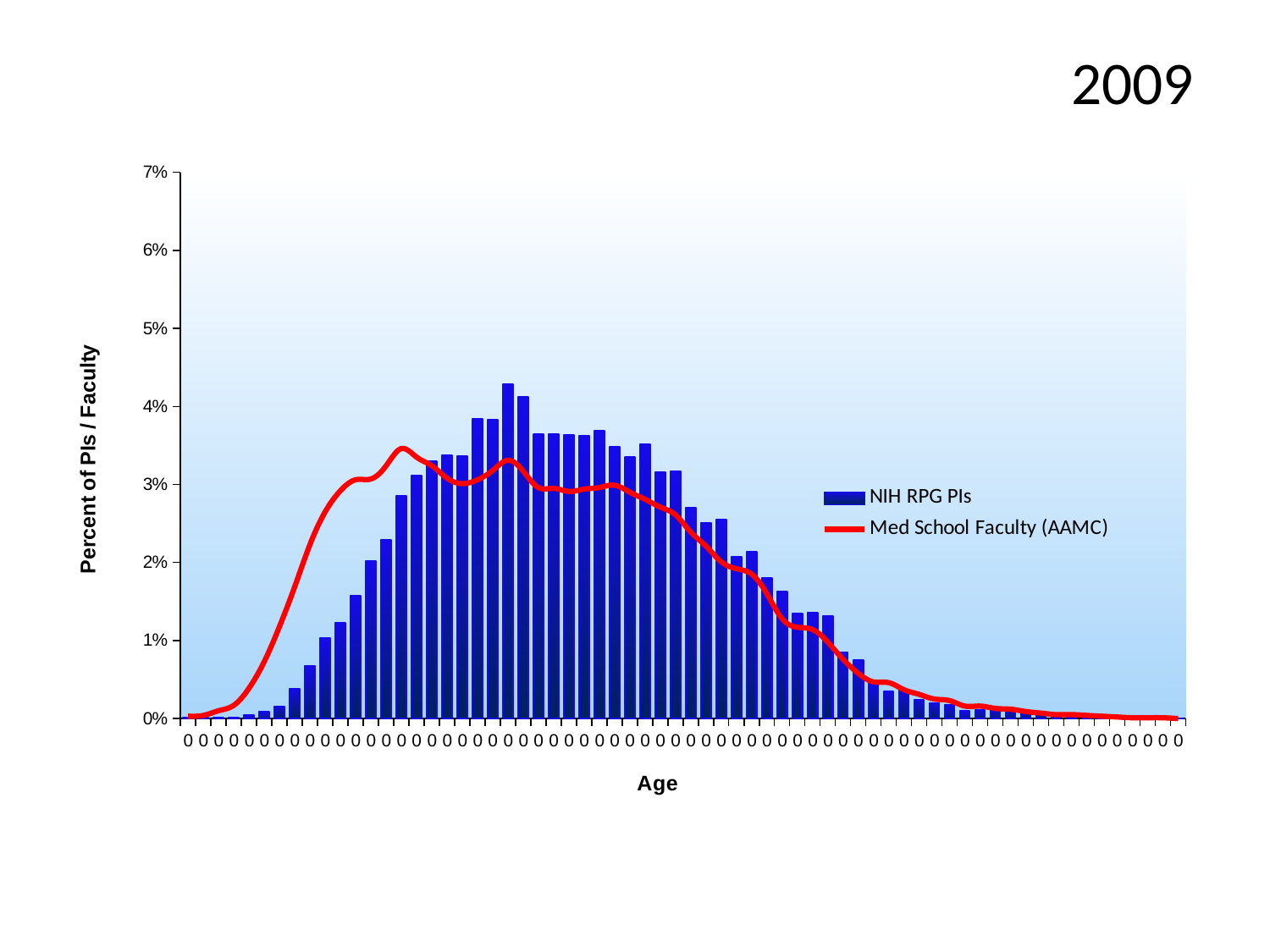
Which series is drawn as a red line? Med School Faculty (AAMC) Which series is drawn as blue bars? NIH RPG PIs Toward the right end of the x axis, do the NIH RPG PIs bars rise or fall? fall How many series does the legend list? 2 Which series reaches a higher peak value, NIH RPG PIs or Med School Faculty (AAMC)? NIH RPG PIs Is the highest point of the Med School Faculty (AAMC) line greater or less than 3%? greater What is the highest tick value shown on the y axis? 7% Is the highest point of the Med School Faculty (AAMC) line greater or less than 4%? less What kind of chart is shown on the slide? A bar chart with a line series overlaid Is the tallest NIH RPG PIs bar greater or less than 4%? greater